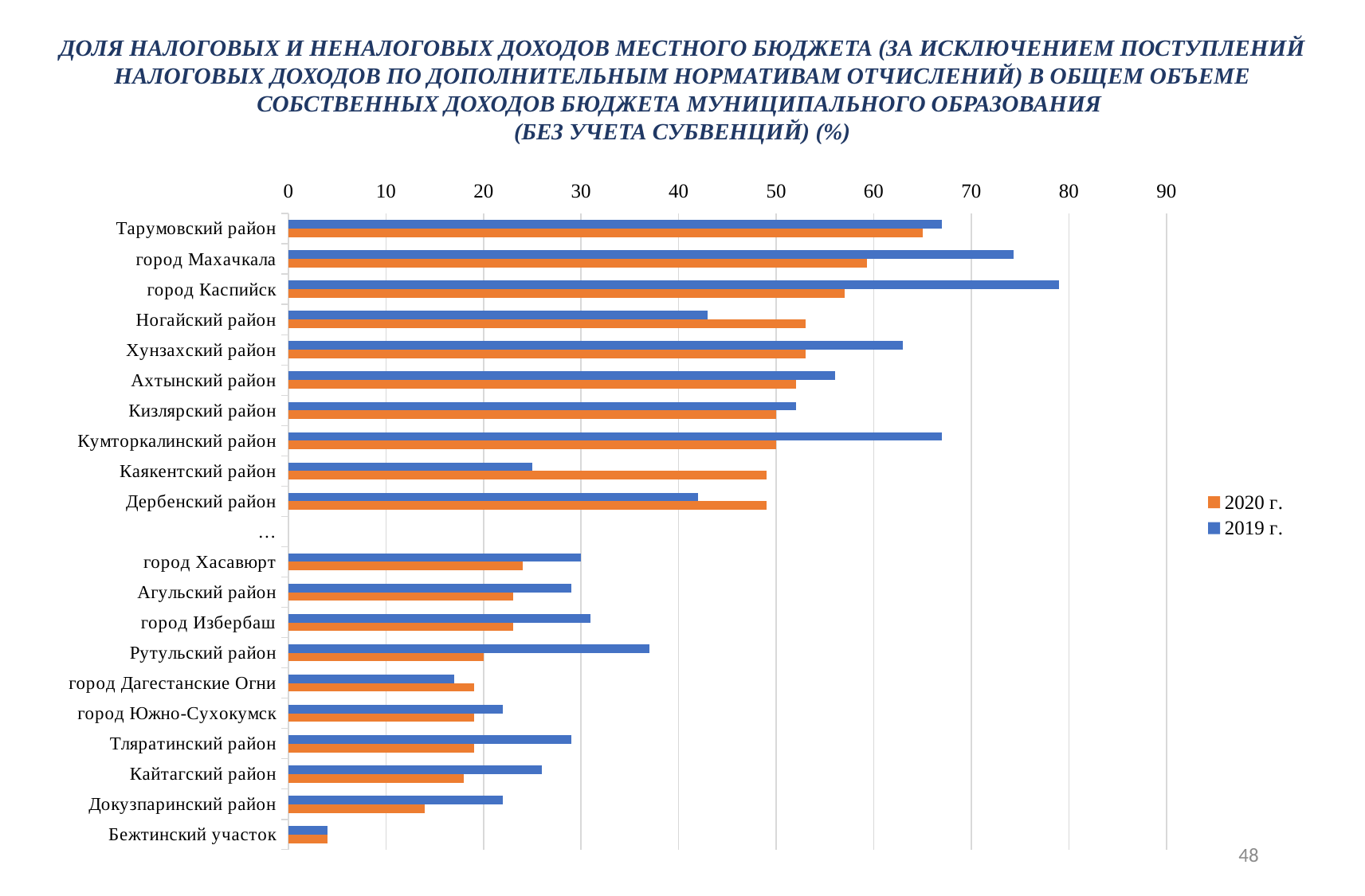
How many series does the legend list? 2 Is the 2019 г. value for город Махачкала greater or less than 70? greater Which category has the highest value for 2019 г.? город Каспийск Is the 2019 г. value for Рутульский район greater or less than 30? greater Which colour represents the 2020 г. series in the legend? orange What kind of chart is shown on the slide? bar chart Which category has the lowest value for 2019 г.? Бежтинский участок Is the 2020 г. value for Каякентский район greater or less than 40? greater For Кумторкалинский район, which year has the larger value, 2019 г. or 2020 г.? 2019 г. For Ногайский район, which year has the larger value, 2019 г. or 2020 г.? 2020 г. Which category has the highest value for 2020 г.? Тарумовский район